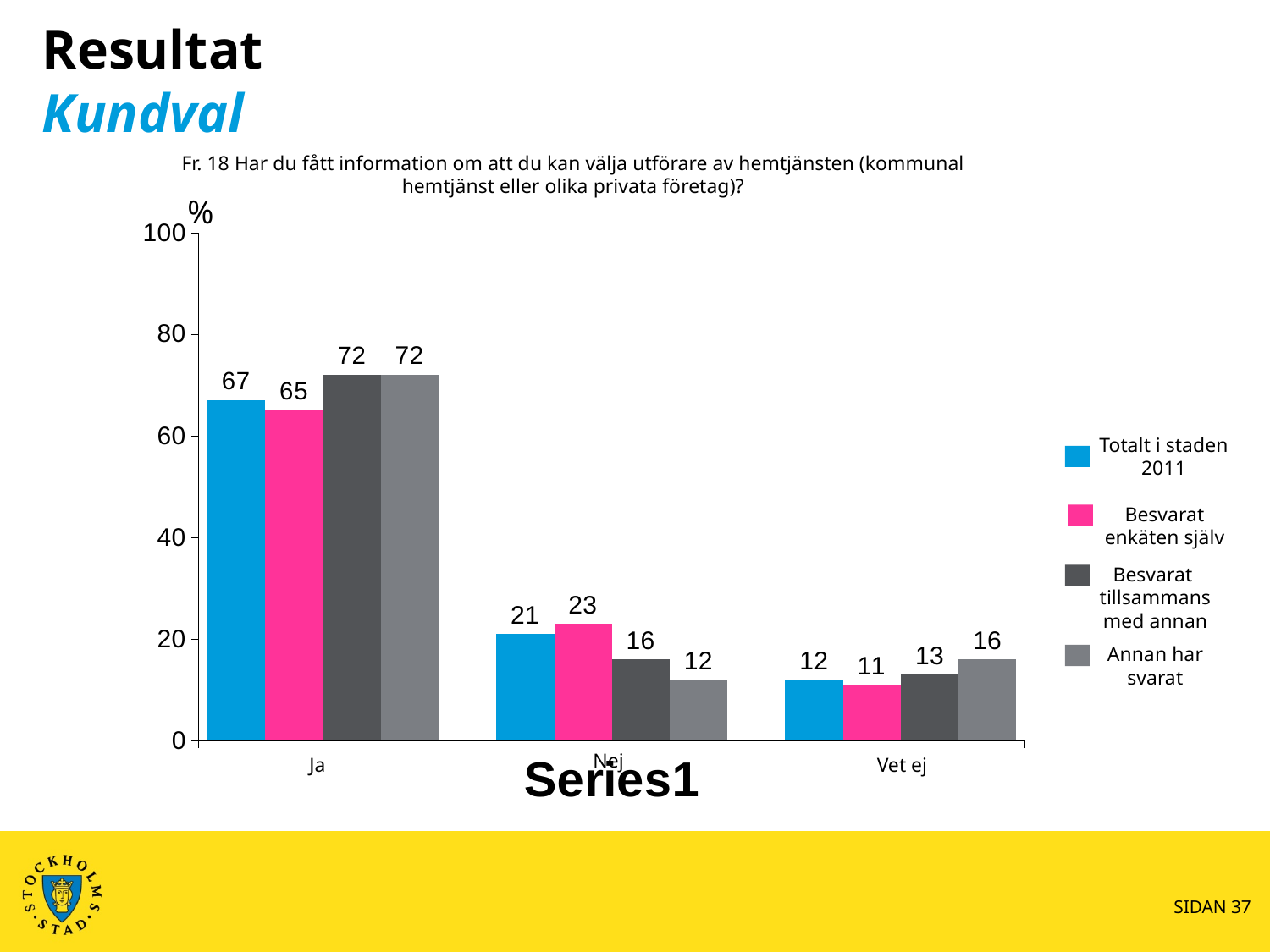
Which category has the highest value for 'Totalt i staden 2011'? Ja What is the difference between the 'Totalt i staden 2011' value and the 'Annan har svarat' value in the 'Nej' category? 9 What is the value for 'Annan har svarat' in the 'Vet ej' category? 16 Which category has the lowest value for 'Besvarat enkäten själv'? Vet ej In the 'Vet ej' category, which is larger: 'Besvarat tillsammans med annan' or 'Besvarat enkäten själv'? Besvarat tillsammans med annan How many series does the legend list? 4 What kind of chart is shown on the slide? Bar chart What is the value for 'Besvarat enkäten själv' in the 'Nej' category? 23 How many categories are shown on the x axis? 3 What is the value for 'Besvarat tillsammans med annan' in the 'Ja' category? 72 Is the value for 'Besvarat enkäten själv' in the 'Ja' category greater or less than 60? greater What is the value for 'Totalt i staden 2011' in the 'Ja' category? 67